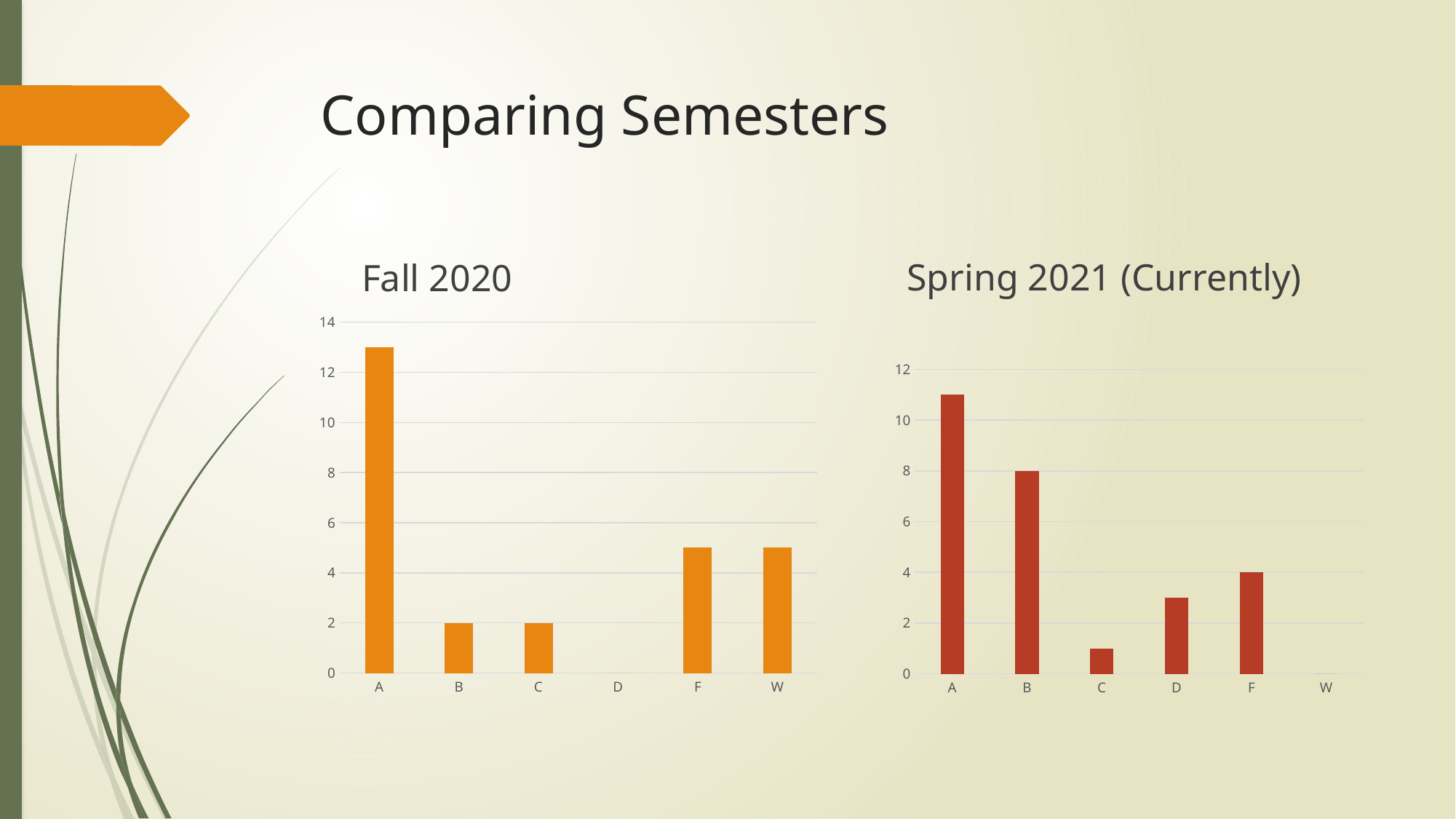
In the Fall 2020 chart, which category has the highest value? A In the Spring 2021 (Currently) chart, which category has the lowest value? W In the Spring 2021 (Currently) chart, what is the value for B? 8 In the Spring 2021 (Currently) chart, which is larger, the value for B or the value for D? B In the Spring 2021 (Currently) chart, what is the difference between the values for B and F? 4 In the Fall 2020 chart, is the value for A greater or less than 12? greater In the Spring 2021 (Currently) chart, what is the value for F? 4 How many categories are shown on the x axis of the Fall 2020 chart? 6 In the Spring 2021 (Currently) chart, is the value for C greater or less than 2? less In the Spring 2021 (Currently) chart, which category has the highest value? A What kind of chart is the Fall 2020 chart? bar chart In the Fall 2020 chart, what is the value for B? 2